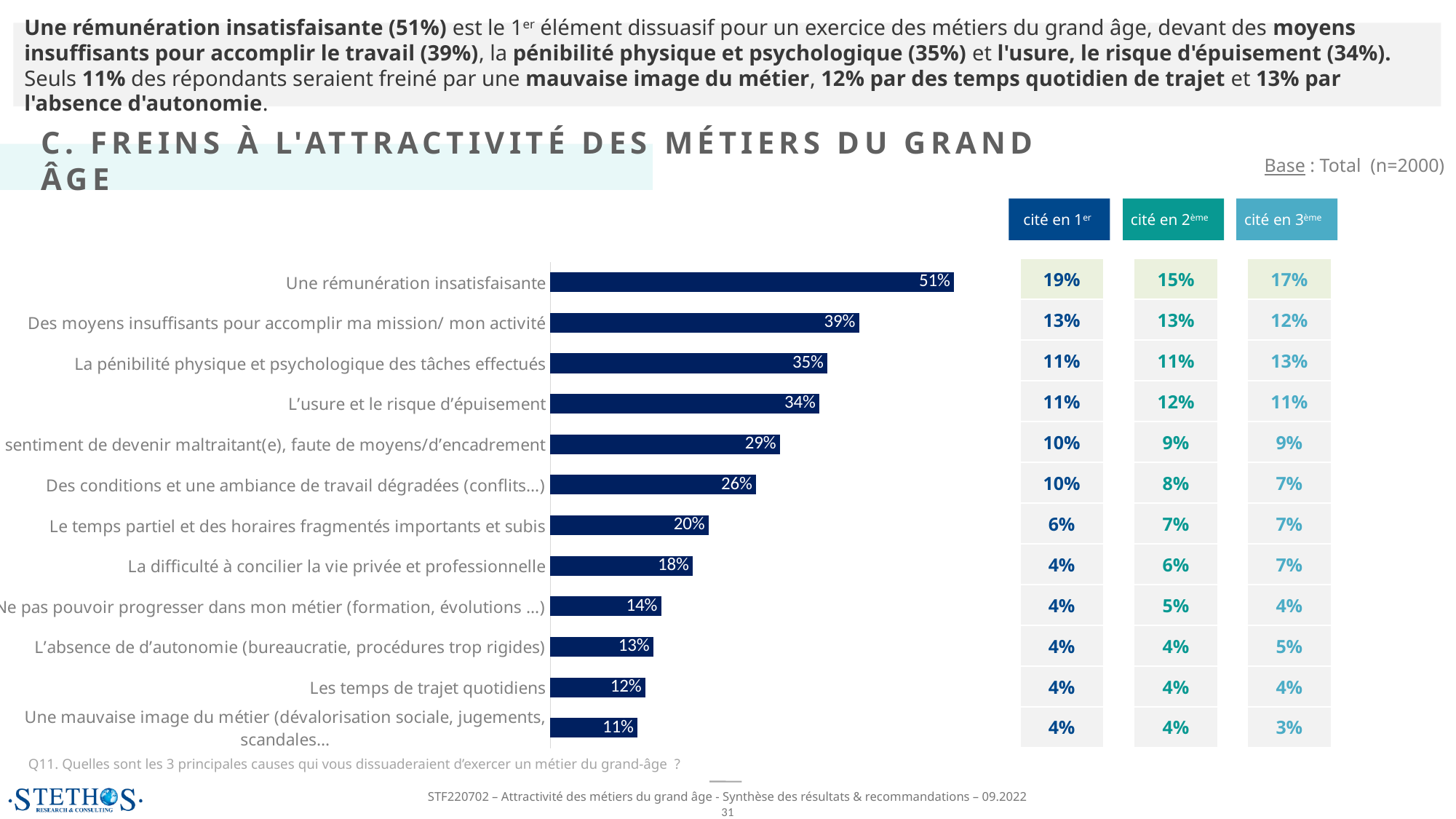
Which category has the highest value? Une rémunération insatisfaisante What is the value for "Une rémunération insatisfaisante"? 51% What is the title of the section shown above the chart? C. Freins à l'attractivité des métiers du grand âge How many categories are shown in the bar chart? 12 What is the difference between "Une rémunération insatisfaisante" and "Des moyens insuffisants pour accomplir ma mission/ mon activité"? 12 percentage points What is the value for "La difficulté à concilier la vie privée et professionnelle"? 18% What kind of chart is shown on the slide? Bar chart Do the bar values increase or decrease from the top category to the bottom category? Decrease Which is larger: "La pénibilité physique et psychologique des tâches effectués" or "L'usure et le risque d'épuisement"? La pénibilité physique et psychologique des tâches effectués What is the value for "Le temps partiel et des horaires fragmentés importants et subis"? 20% What is the difference between "Le sentiment de devenir maltraitant(e), faute de moyens/d'encadrement" and "Des conditions et une ambiance de travail dégradées (conflits…)"? 3 percentage points Which category has the lowest value? Une mauvaise image du métier (dévalorisation sociale, jugements, scandales…)